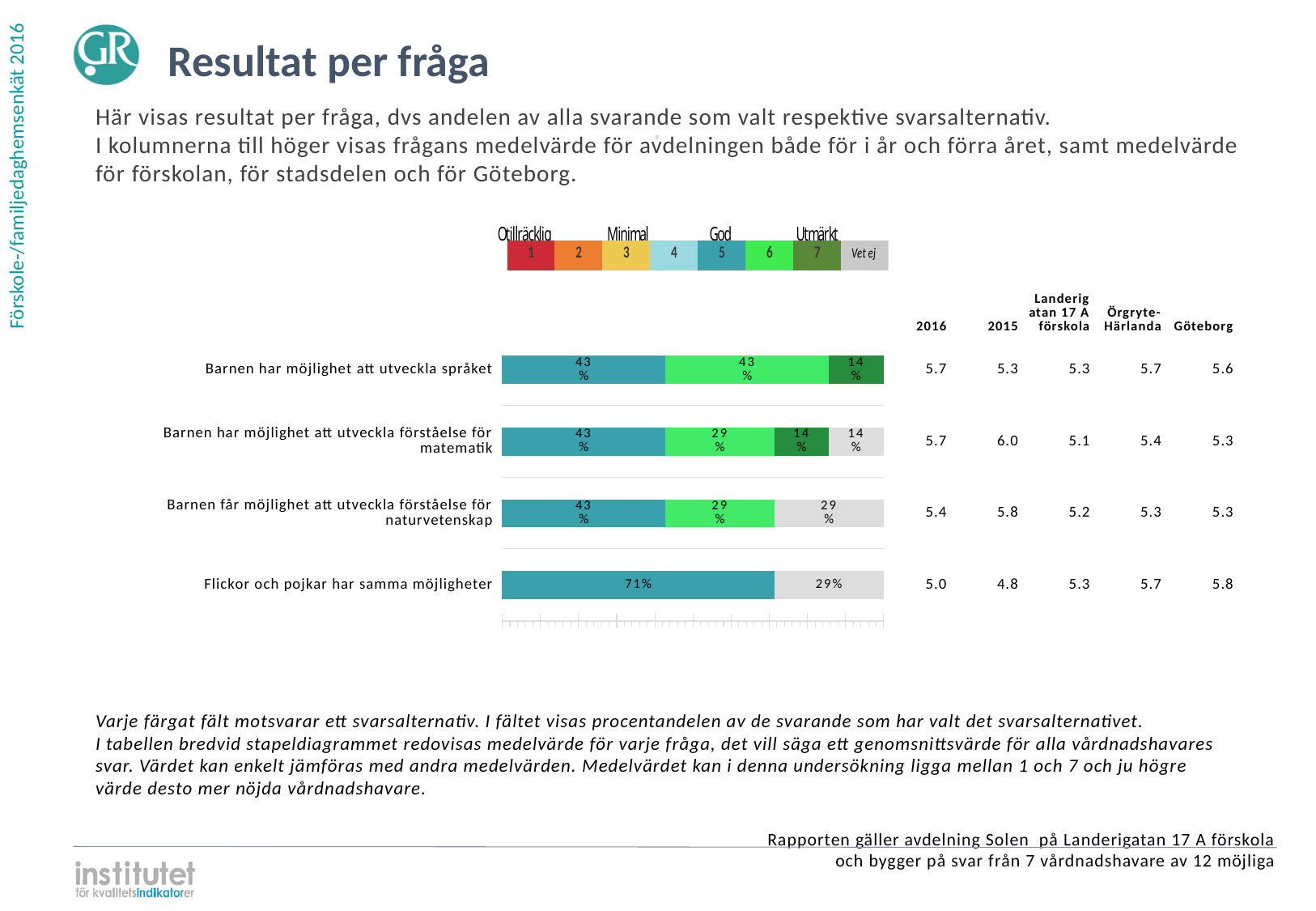
What percentage chose 'Vet ej' for 'Barnen får möjlighet att utveckla förståelse för naturvetenskap'? 29% What percentage of respondents chose answer 5 (God) for 'Flickor och pojkar har samma möjligheter'? 71% For 'Barnen har möjlighet att utveckla förståelse för matematik', which is larger: the 2016 mean or the 2015 mean? 2015 (6.0) What is the 2016 mean value for 'Barnen får möjlighet att utveckla förståelse för naturvetenskap'? 5.4 What is the Göteborg mean value for 'Flickor och pojkar har samma möjligheter'? 5.8 What percentage chose answer 7 (Utmärkt) for 'Barnen har möjlighet att utveckla språket'? 14% How many questions (categories) are shown as bars in the chart? 4 What is the difference between the share choosing answer 5 for 'Flickor och pojkar har samma möjligheter' and for 'Barnen har möjlighet att utveckla språket'? 28 percentage points What is the total of the segments in the bar for 'Barnen har möjlighet att utveckla språket'? 100% Which answer alternative does the dark green colour in the legend represent? 7 (Utmärkt) What kind of chart is used to show the results per question? Stacked bar chart Which question has the largest share of respondents choosing answer 5 (God)? Flickor och pojkar har samma möjligheter